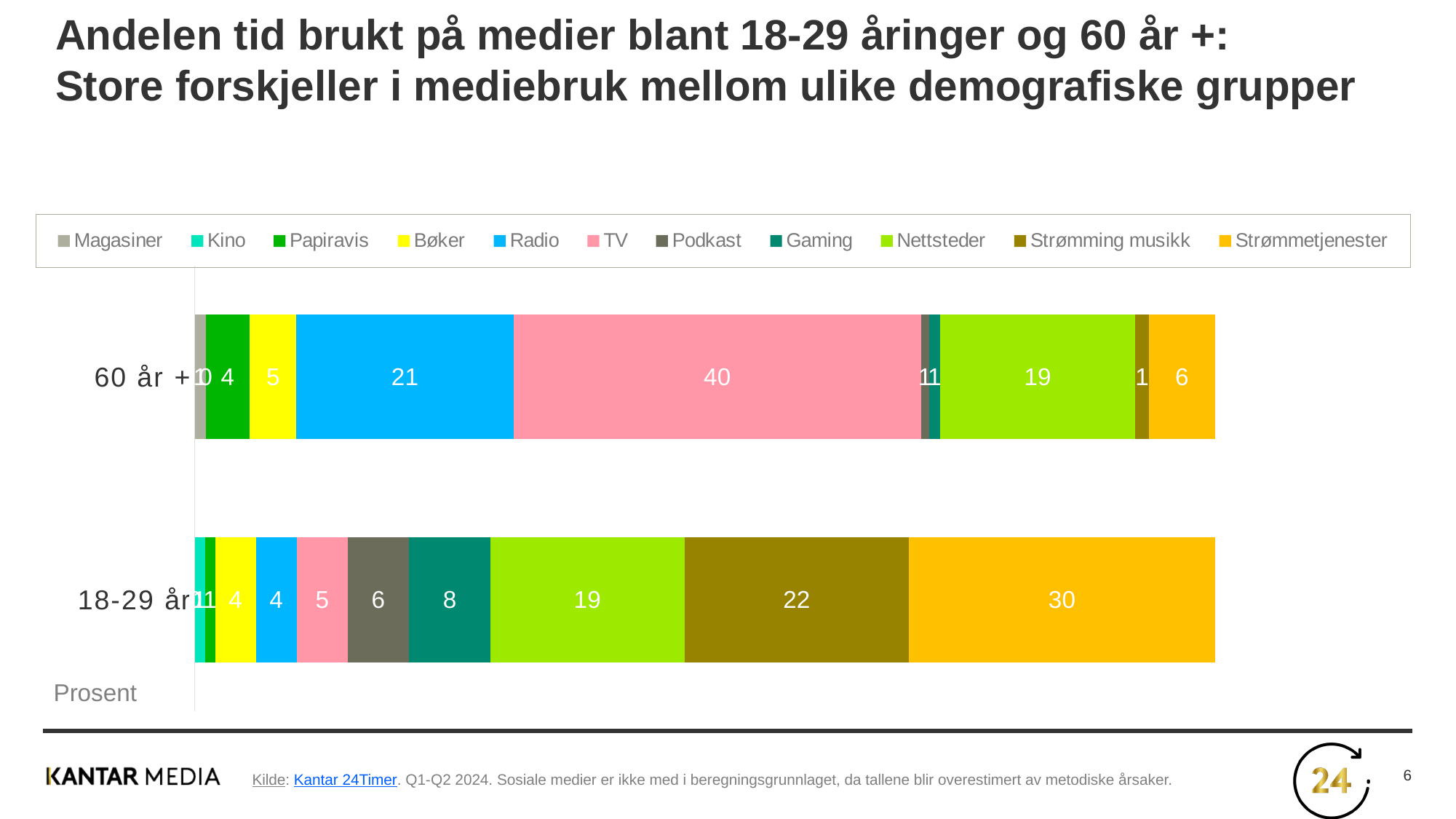
What is the value for Strømmetjenester in the 18-29 år bar? 30 What kind of chart is shown on the slide? Stacked bar chart What is the value for Strømming musikk in the 18-29 år bar? 22 How many age groups (bars) are shown in the chart? 2 What is the difference between the TV value for 60 år + and the TV value for 18-29 år? 35 How many series does the legend list? 11 What is the value for Radio in the 60 år + bar? 21 Which media type has the largest share in the 18-29 år bar? Strømmetjenester What is the value for Gaming in the 18-29 år bar? 8 What is the value for TV in the 60 år + bar? 40 Which media type has the largest share in the 60 år + bar? TV Which group has the larger value for Radio, 60 år + or 18-29 år? 60 år +